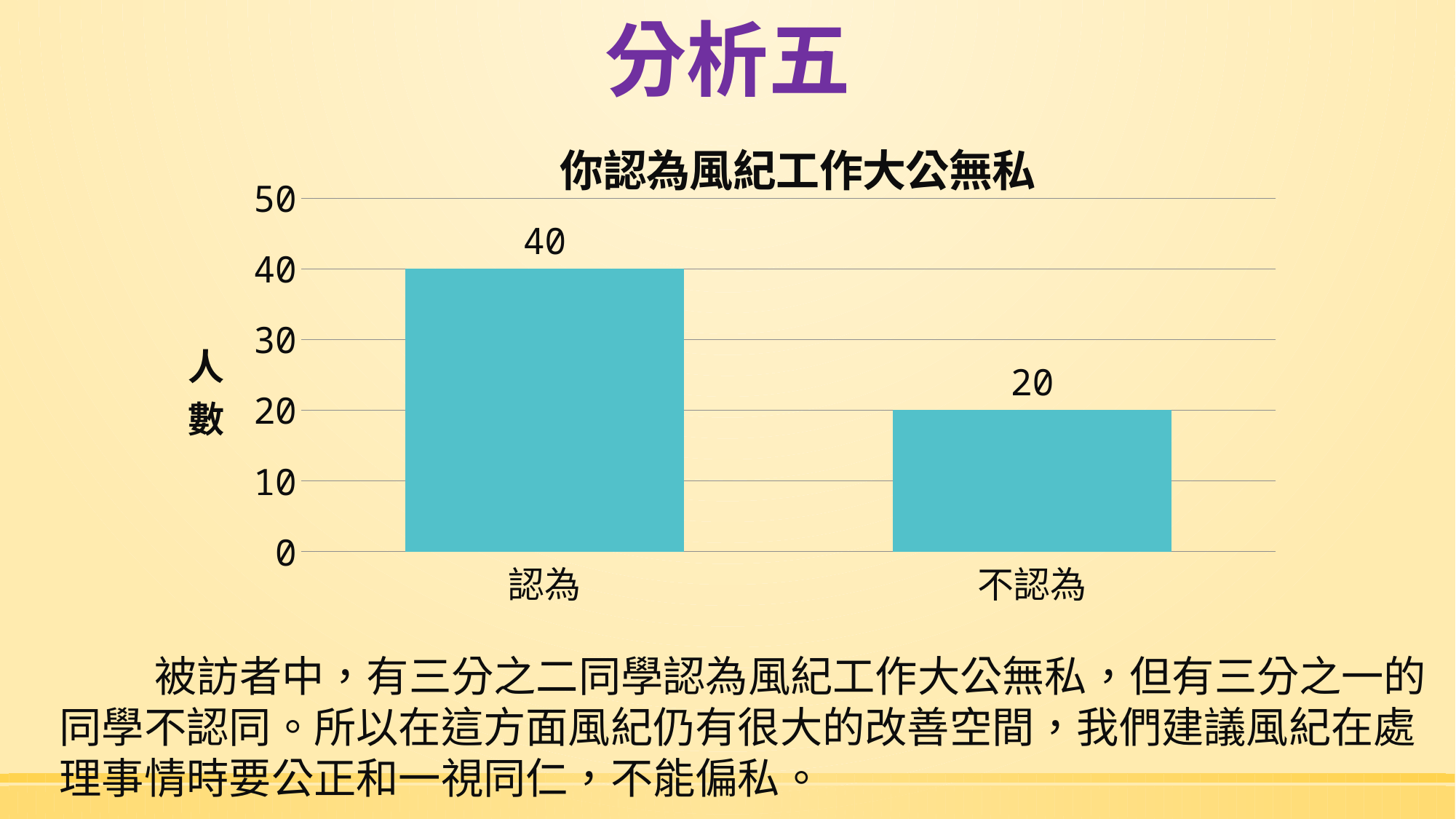
What is the difference between the values for 認為 and 不認為? 20 Which category has the highest value? 認為 Which category has the lowest value? 不認為 What is the value for 不認為? 20 Is the value for 認為 greater or less than 30? greater How many categories are shown on the x axis? 2 Which is larger, the value for 認為 or the value for 不認為? 認為 What kind of chart is shown on the slide? bar chart What is the value for 認為? 40 Is the value for 不認為 greater or less than 30? less What is the title of the chart? 你認為風紀工作大公無私 What is the label of the vertical axis? 人數